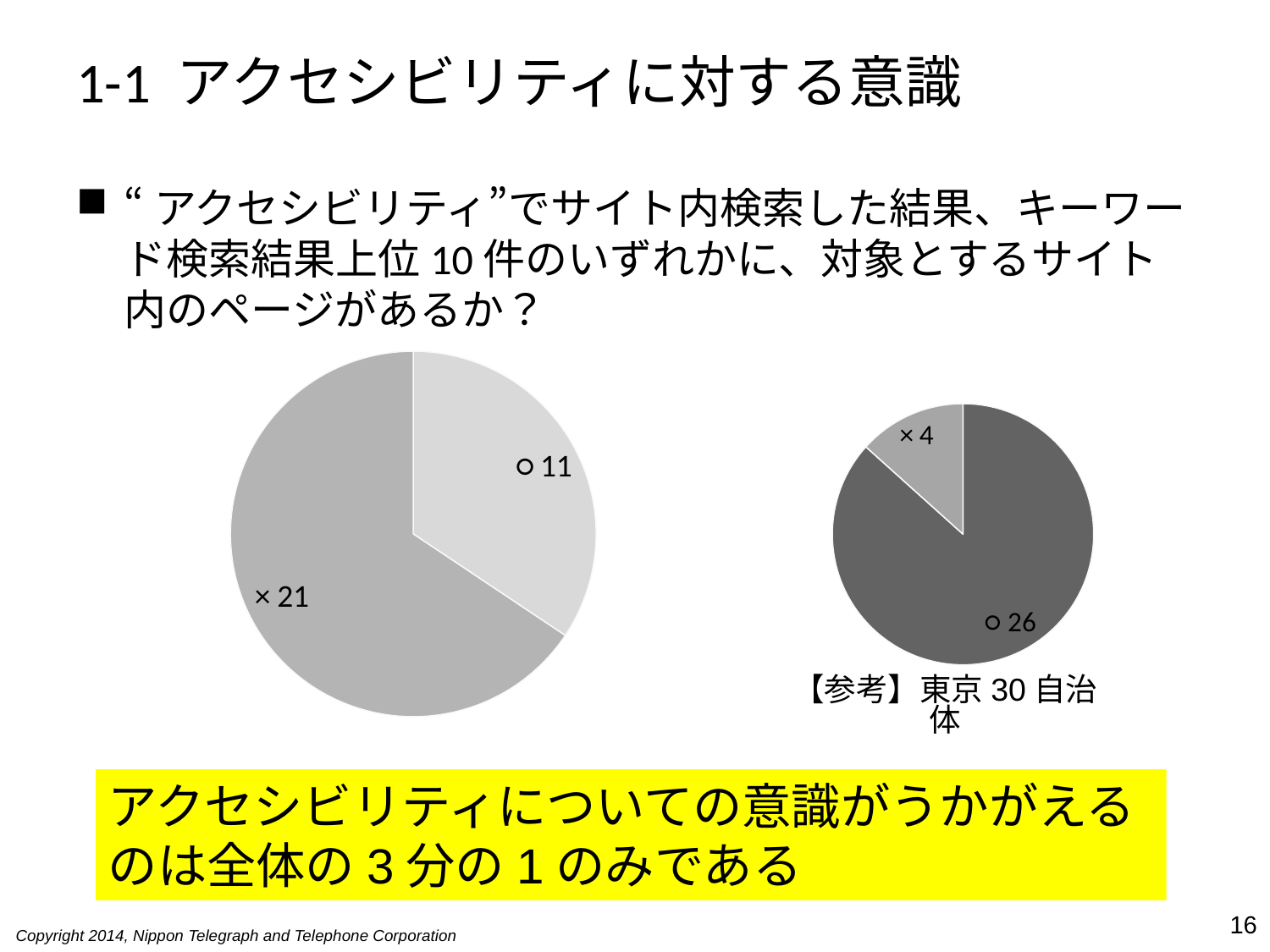
On the left pie chart, what is the value for the × slice? 21 On the left pie chart, which slice is larger, ○ or ×? × On the right pie chart (【参考】東京30自治体), what is the value for the × slice? 4 On the right pie chart (【参考】東京30自治体), which slice is the largest? ○ What type of chart is the chart on the right of the slide? Pie chart On the left pie chart, what is the difference between the × value and the ○ value? 10 How many slices does the left pie chart have? 2 On the left pie chart, what is the value for the ○ slice? 11 On the left pie chart, what is the total of the two slices? 32 On the right pie chart (【参考】東京30自治体), what is the difference between the ○ value and the × value? 22 On the right pie chart (【参考】東京30自治体), what is the value for the ○ slice? 26